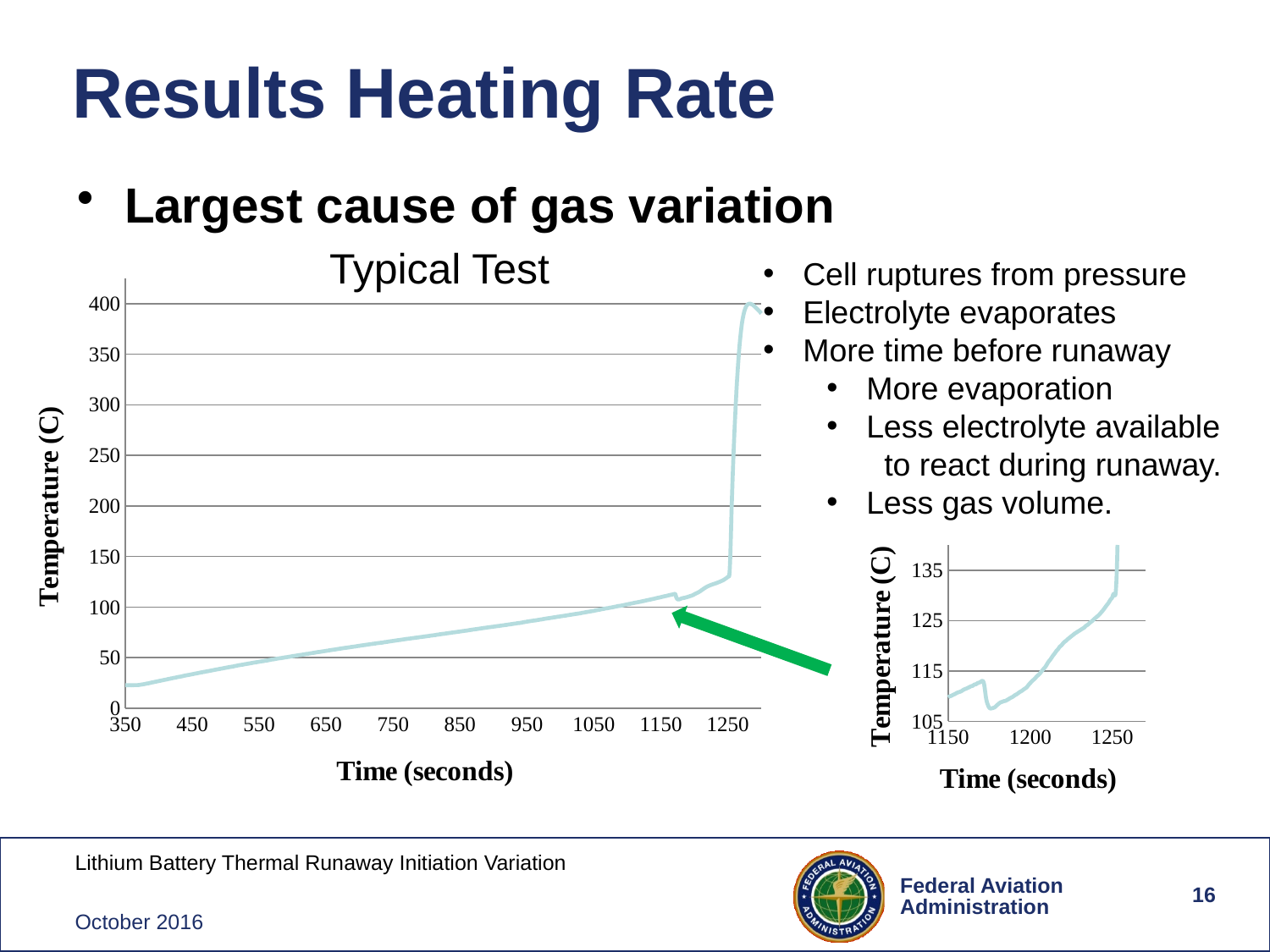
In the "Typical Test" chart, is the temperature at 350 seconds greater or less than 50? less In the small chart at the bottom right, does the temperature generally rise or fall from 1150 to 1250 seconds? rise How many charts are shown on the slide? 2 In the "Typical Test" chart, is the temperature at 750 seconds greater or less than 50? greater In the "Typical Test" chart, is the highest temperature reached greater or less than 350? greater What is the title of the large chart on the left? Typical Test What type of chart is the "Typical Test" chart? line chart In the "Typical Test" chart, does the temperature generally rise or fall as time increases? rise In the "Typical Test" chart, what is the label of the y axis? Temperature (C)